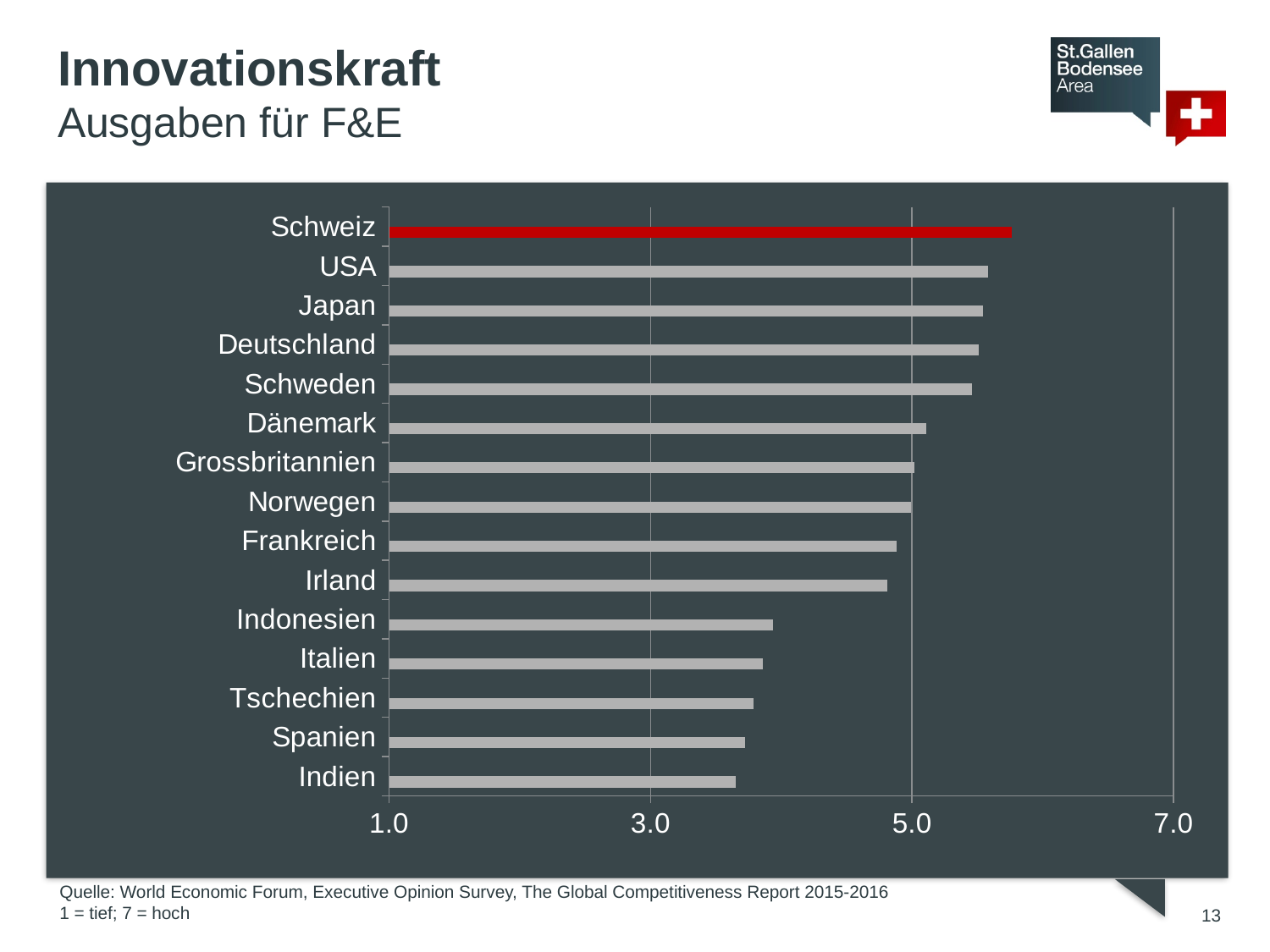
Which country has the highest value in the chart? Schweiz Do the bar values increase or decrease from the top of the chart to the bottom? decrease Is the value for Indonesien greater or less than 5.0? less Which has the larger value, Schweiz or USA? Schweiz Which has the larger value, Irland or Indonesien? Irland Is the value for Indien greater or less than 5.0? less Which country has the lowest value in the chart? Indien Which country's bar is highlighted in red? Schweiz What kind of chart is shown on the slide? bar chart Is the value for Spanien greater or less than 3.0? greater How many countries are shown in the chart? 15